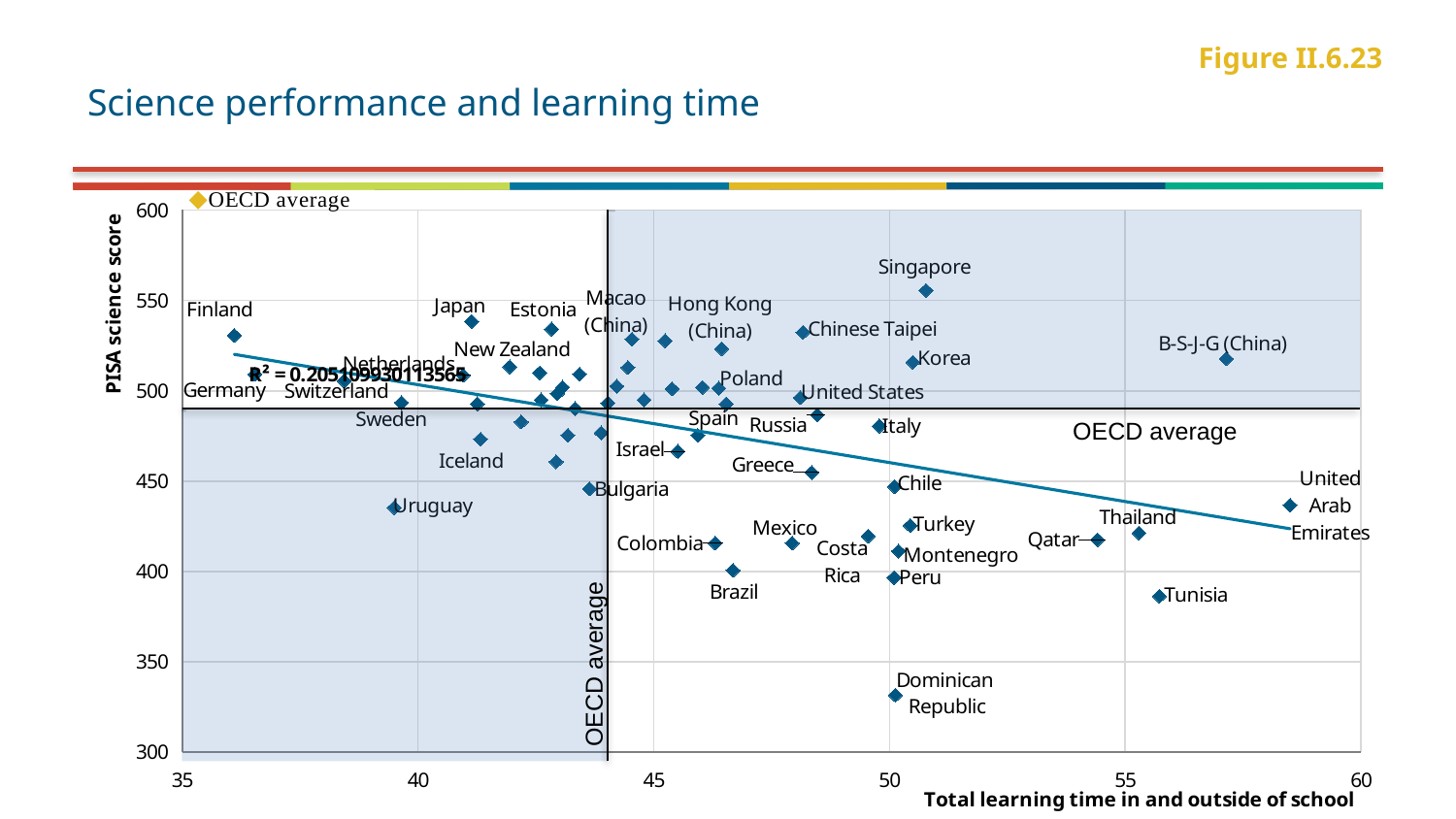
Which country has the lowest PISA science score in the chart? Dominican Republic Which has the higher PISA science score, Singapore or Korea? Singapore What kind of chart is shown on the slide? Scatter plot Which country has the largest total learning time in and outside of school? United Arab Emirates What is the title of the chart? Science performance and learning time Which country has the smallest total learning time in and outside of school? Finland Is the total learning time for the United Arab Emirates greater or less than 55? greater Which country has the highest PISA science score in the chart? Singapore What is the label of the vertical axis? PISA science score Is the PISA science score for Finland greater or less than 500? greater Is the PISA science score for the Dominican Republic greater or less than 350? less As total learning time increases along the x axis, does the fitted trend line rise or fall? fall